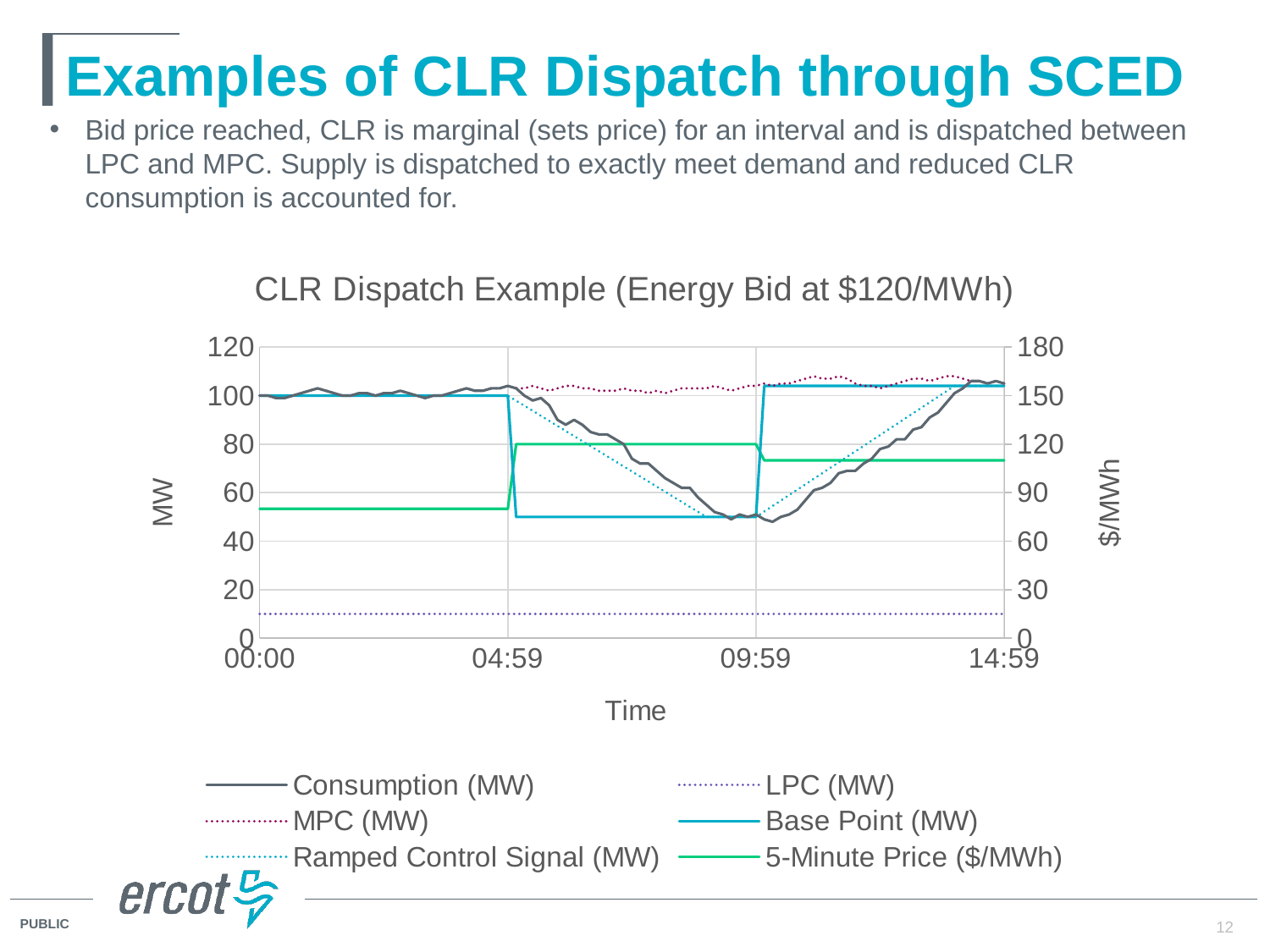
What is the label of the right-hand vertical axis? $/MWh What kind of chart is shown on the slide? line chart Between 04:59 and 09:59, which is larger: MPC (MW) or Base Point (MW)? MPC (MW) Does the Ramped Control Signal (MW) series rise or fall between 09:59 and 14:59? rise Is the value of the LPC (MW) series greater or less than 20? less What is the value of the 5-Minute Price ($/MWh) series between 04:59 and 09:59? 120 Does the Consumption (MW) series rise or fall between 04:59 and 09:59? fall How many series does the legend list? 6 Is the 5-Minute Price ($/MWh) between 00:00 and 04:59 greater or less than 60? greater What is the title of the chart? CLR Dispatch Example (Energy Bid at $120/MWh) Is the value of the Base Point (MW) series between 04:59 and 09:59 greater or less than 60? less